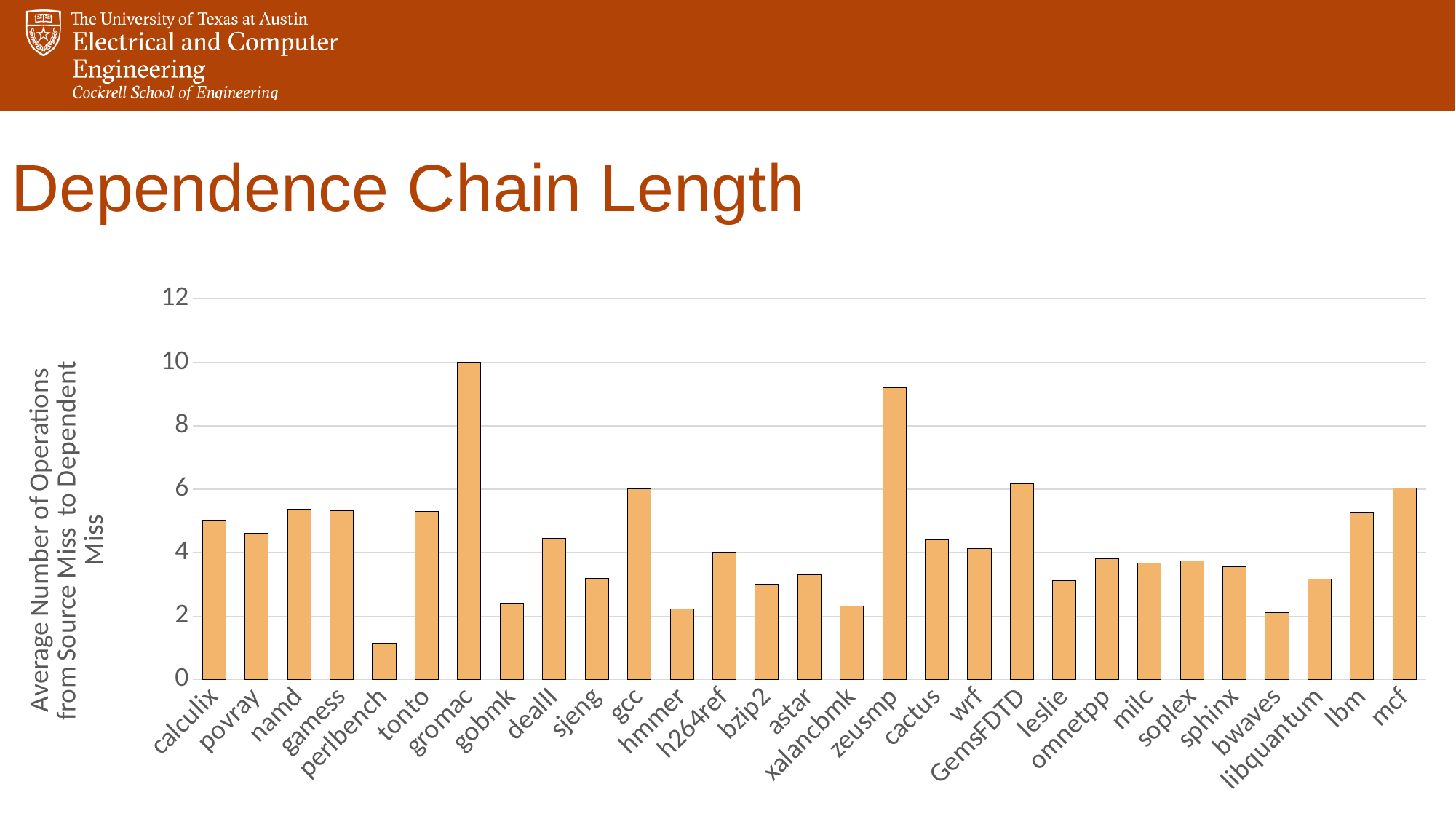
Which benchmark has the highest average number of operations from source miss to dependent miss? gromac Is the value for zeusmp greater or less than 8? greater What is the label of the y axis? Average Number of Operations from Source Miss to Dependent Miss Is the value for hmmer greater or less than 4? less Which has a larger value, bwaves or lbm? lbm Which has a larger value, gromac or zeusmp? gromac What kind of chart is shown on the slide? bar chart Is the value for perlbench greater or less than 2? less How many benchmarks are plotted on the x axis? 29 Which benchmark has the lowest average number of operations from source miss to dependent miss? perlbench What is the title of the slide containing the chart? Dependence Chain Length